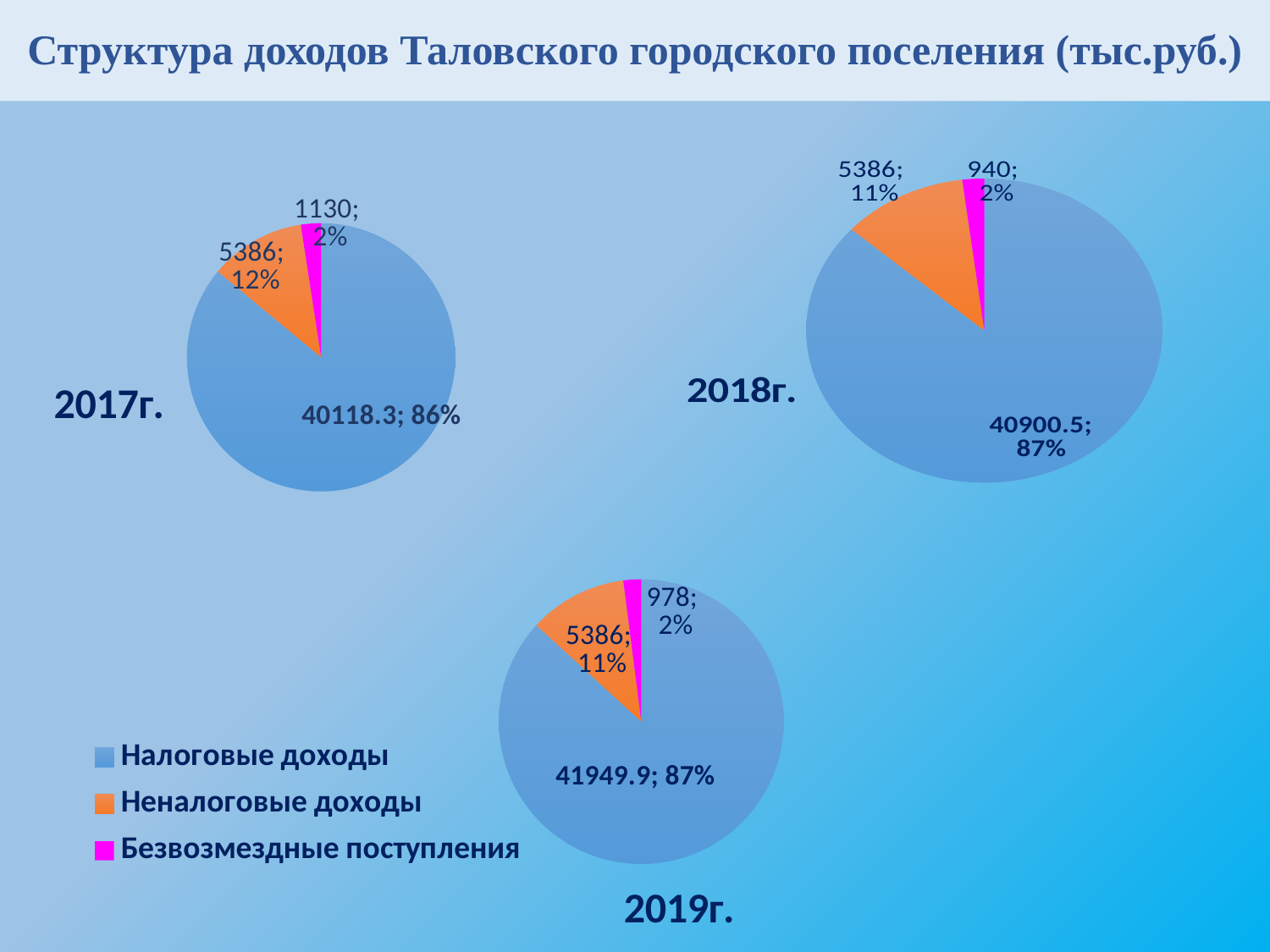
Which is larger: Безвозмездные поступления in the 2017г. chart or in the 2019г. chart? 2017г. Which colour represents Неналоговые доходы in the legend? Orange In the 2018г. pie chart, which category is the largest? Налоговые доходы In the 2019г. pie chart, what is the value for Неналоговые доходы? 5386 In the 2019г. pie chart, what share of the pie is Налоговые доходы? 87% In the 2018г. pie chart, what is the value for Безвозмездные поступления? 940 In the 2017г. pie chart, which category is the smallest? Безвозмездные поступления In the 2017г. pie chart, what is the value for Налоговые доходы? 40118.3 In the 2019г. pie chart, what is the difference between Налоговые доходы and Неналоговые доходы? 36563.9 What type of chart is used for the 2018г. data? Pie chart How many categories does each pie chart show? 3 In the 2017г. pie chart, what share of the pie is Неналоговые доходы? 12%